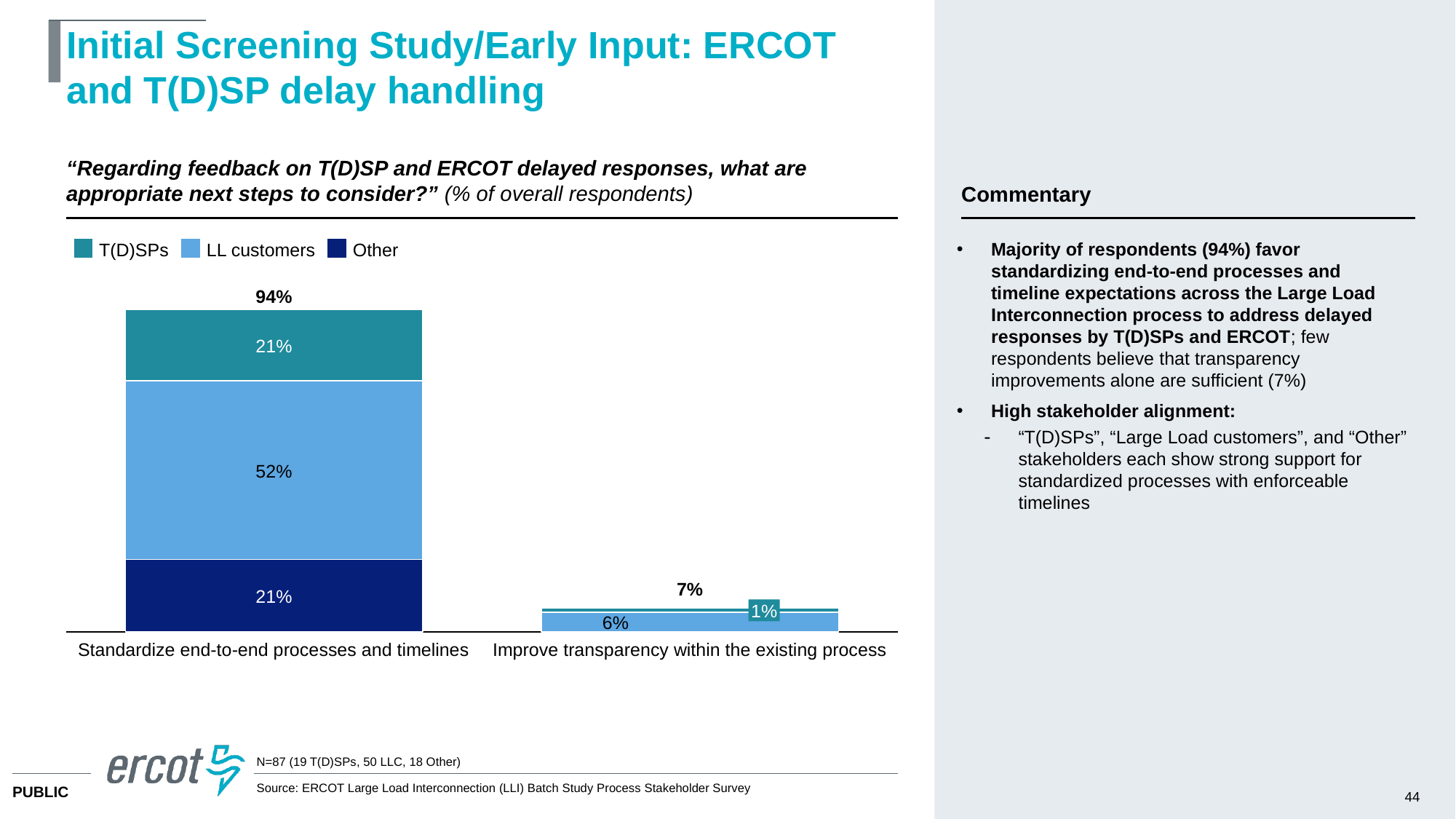
What is the difference between the totals of the two bars? 87% How many series does the legend list? 3 What is the total for the 'Standardize end-to-end processes and timelines' bar? 94% How many categories are shown on the x axis? 2 Which series is shown in the darkest blue colour in the legend? Other What is the total for the 'Improve transparency within the existing process' bar? 7% Which category has the highest total? Standardize end-to-end processes and timelines What is the T(D)SPs value for 'Standardize end-to-end processes and timelines'? 21% What is the LL customers value for 'Standardize end-to-end processes and timelines'? 52% What kind of chart is shown on the slide? Stacked bar chart What is the LL customers value for 'Improve transparency within the existing process'? 6% What is the T(D)SPs value for 'Improve transparency within the existing process'? 1%